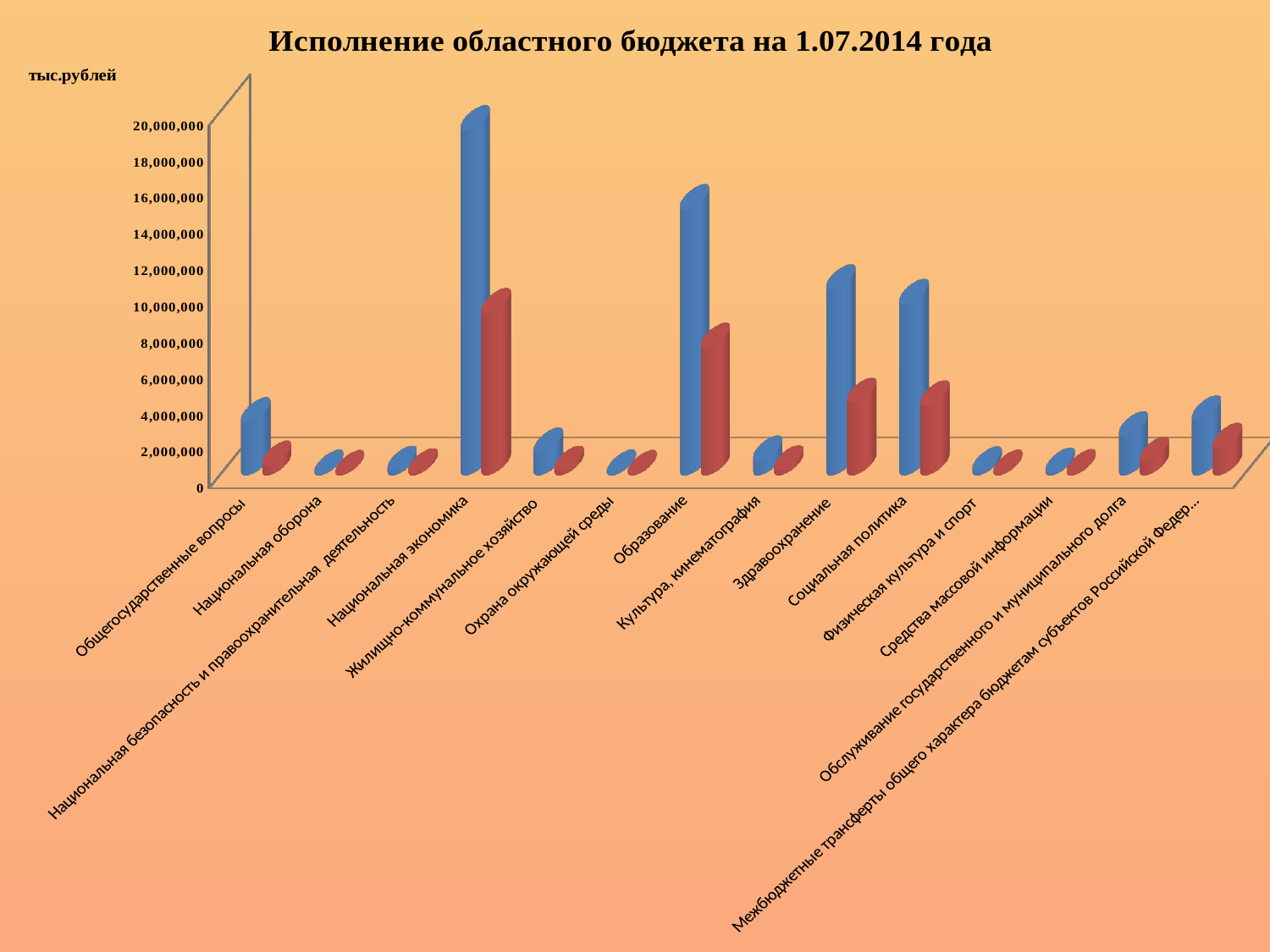
What is the title of the chart? Исполнение областного бюджета на 1.07.2014 года What unit is shown on the vertical axis label? тыс.рублей Which has the taller red bar, Национальная экономика or Образование? Национальная экономика Is the blue bar for Здравоохранение greater or less than 8,000,000? greater How many categories are shown along the horizontal axis? 14 Is the red bar for Охрана окружающей среды greater or less than 2,000,000? less Which has the taller blue bar, Образование or Здравоохранение? Образование Is the blue bar for Национальная экономика greater or less than 16,000,000? greater Which category has the tallest blue bar? Национальная экономика What kind of chart is shown on the slide? bar chart